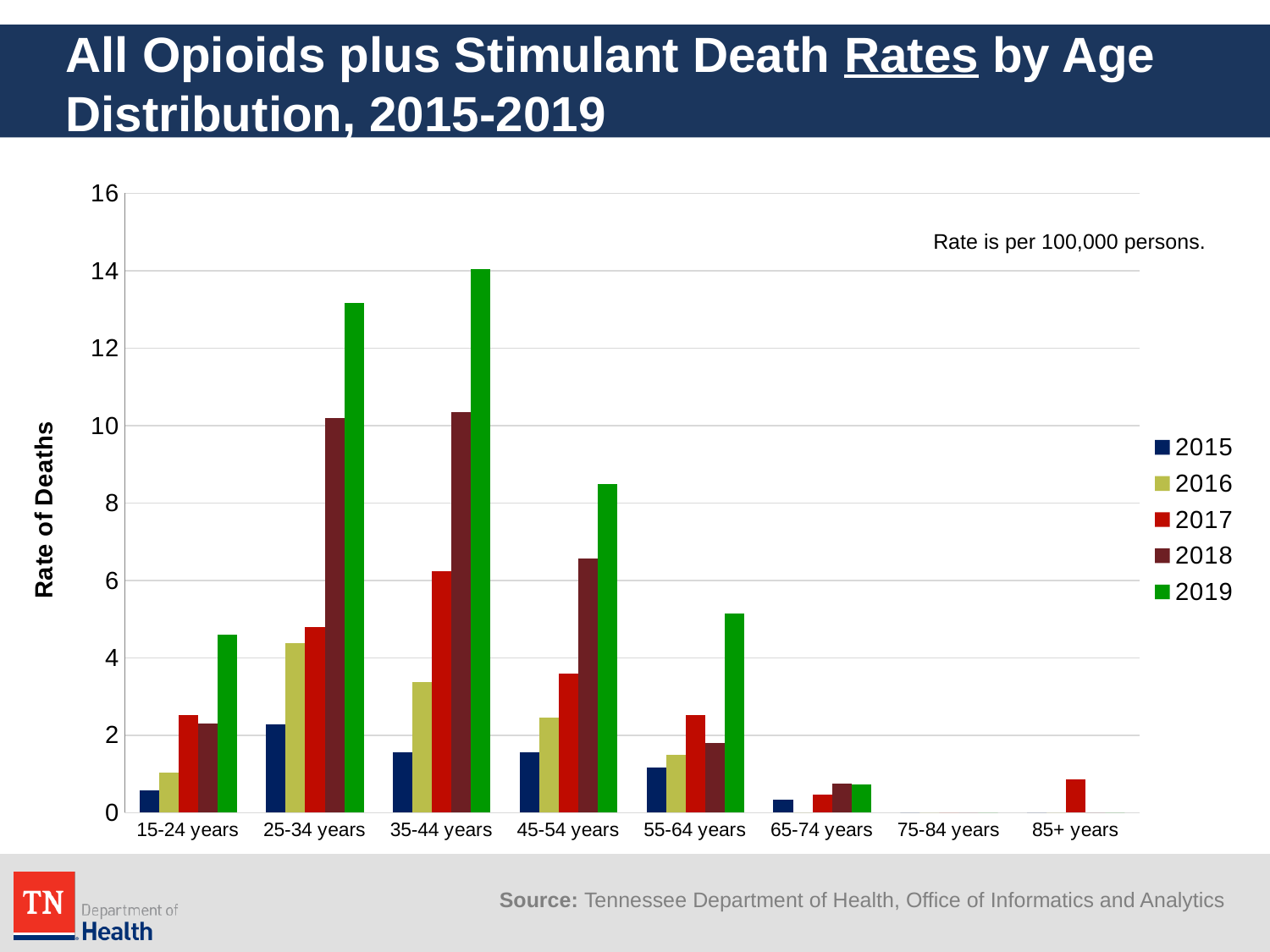
Is the 2017 value for 45-54 years greater or less than 4? less Is the 2018 value for 35-44 years greater or less than 8? greater What kind of chart is shown on the slide? Bar chart What is the title of the y axis? Rate of Deaths Is the 2019 value for 25-34 years greater or less than 12? greater Which age group has the highest 2019 death rate? 35-44 years How many series does the legend list? 5 Which year has the lowest death rate for the 25-34 years group? 2015 How many age groups are shown on the x axis? 8 According to the note on the chart, what is the rate per? Per 100,000 persons For the 35-44 years group, do the rates rise or fall from 2015 to 2019? rise Which is larger, the 2019 value for 45-54 years or the 2019 value for 55-64 years? 45-54 years